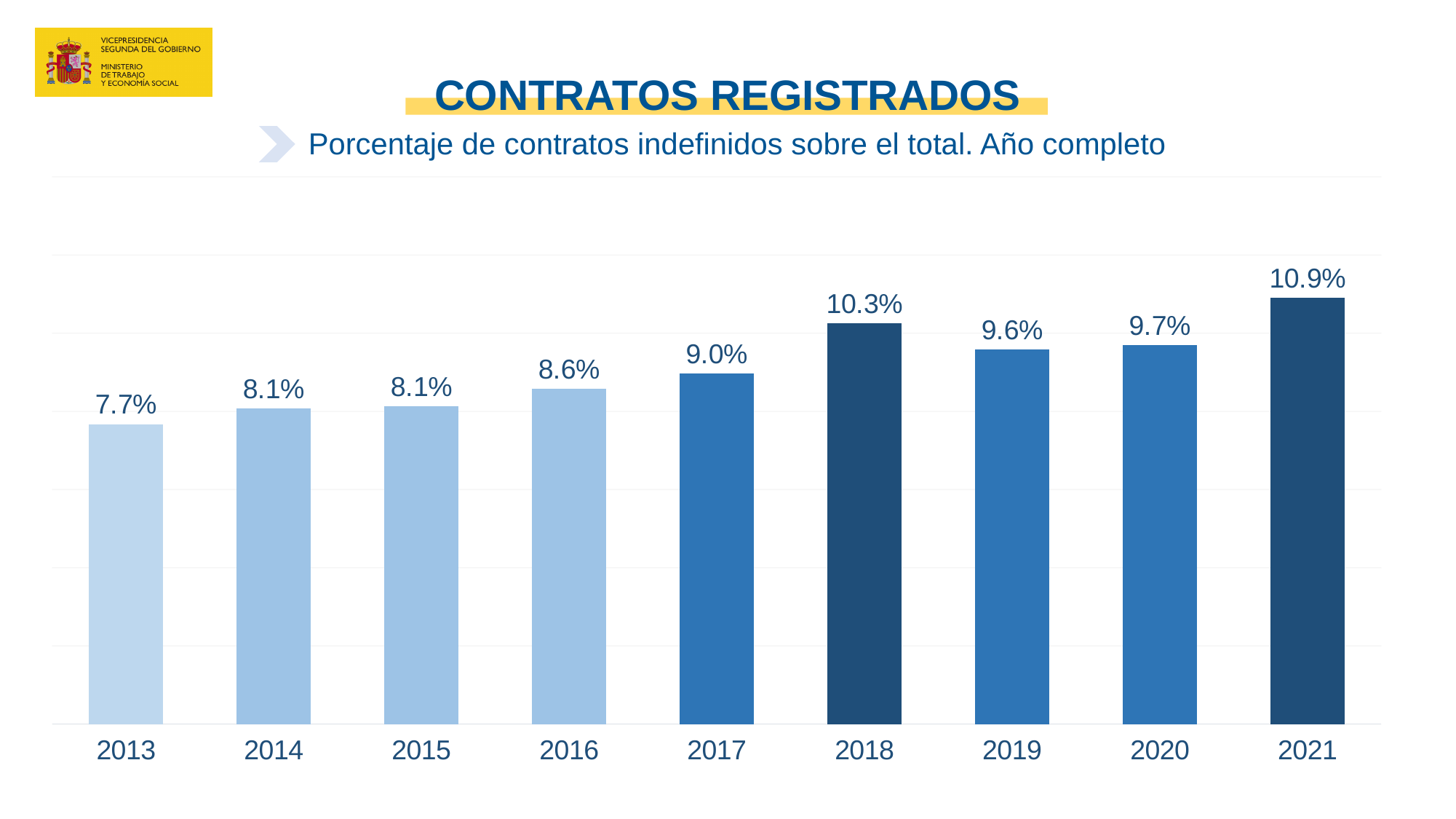
What is the value for 2013? 7.7% Which year has the highest value? 2021 Which year has the lowest value? 2013 Which is larger, the value for 2017 or the value for 2019? 2019 How many years are shown on the x axis? 9 Do the values generally rise or fall from 2013 to 2021? rise What is the difference between the values for 2018 and 2019? 0.7% What is the value for 2018? 10.3% What is the difference between the values for 2021 and 2013? 3.2% What kind of chart is this? bar chart What is the value for 2020? 9.7% What is the title of the chart? Porcentaje de contratos indefinidos sobre el total. Año completo